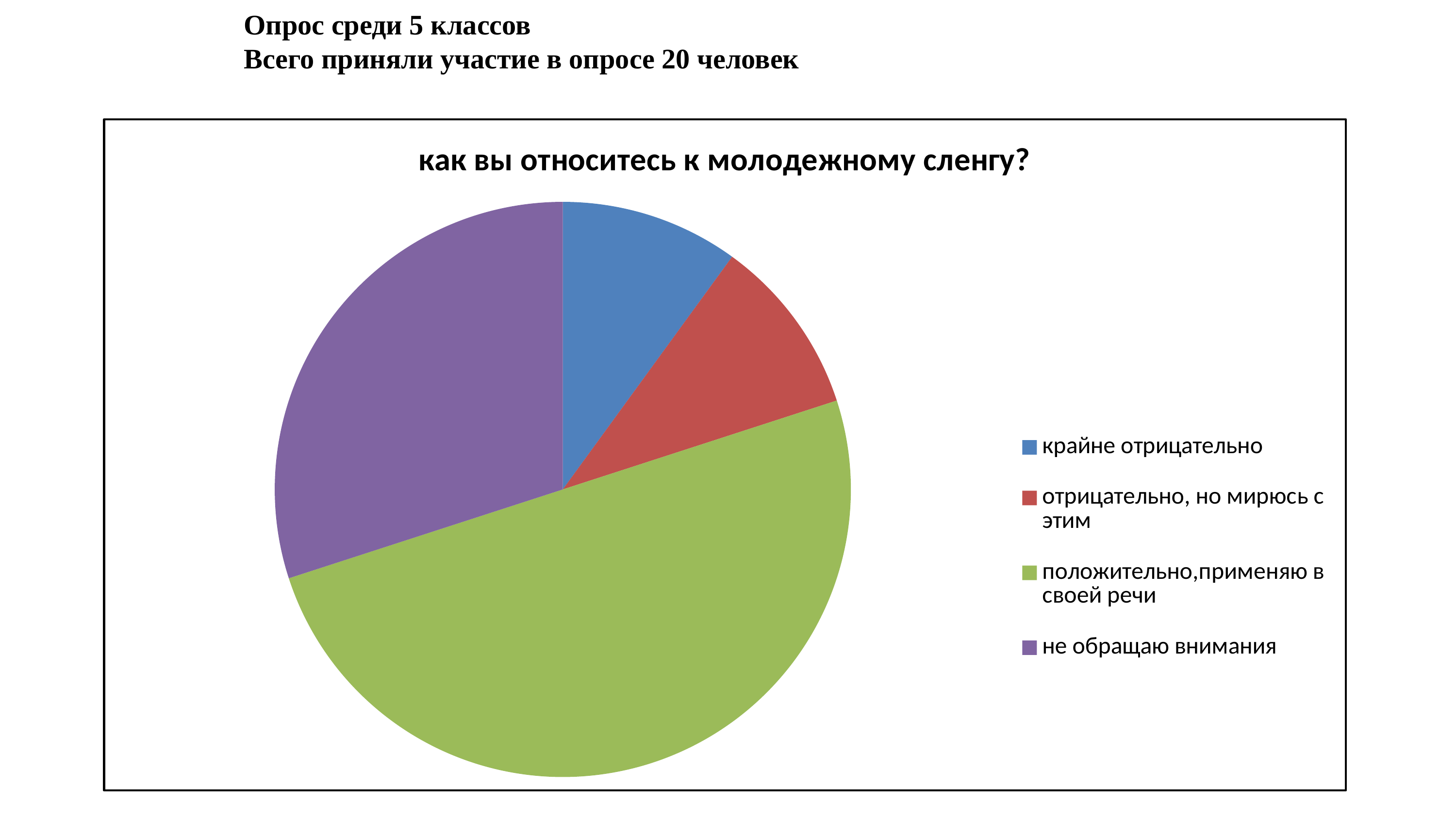
How many entries does the legend list? 4 Which category has the largest slice of the pie? положительно,применяю в своей речи What is the title of the chart? как вы относитесь к молодежному сленгу? Which colour represents "не обращаю внимания" in the chart? purple Which slice is larger: "не обращаю внимания" or "крайне отрицательно"? не обращаю внимания Which slice is larger: "положительно,применяю в своей речи" or "не обращаю внимания"? положительно,применяю в своей речи What kind of chart is shown on the slide? pie chart How many slices does the pie chart have? 4 Which slice is larger: "не обращаю внимания" or "отрицательно, но мирюсь с этим"? не обращаю внимания